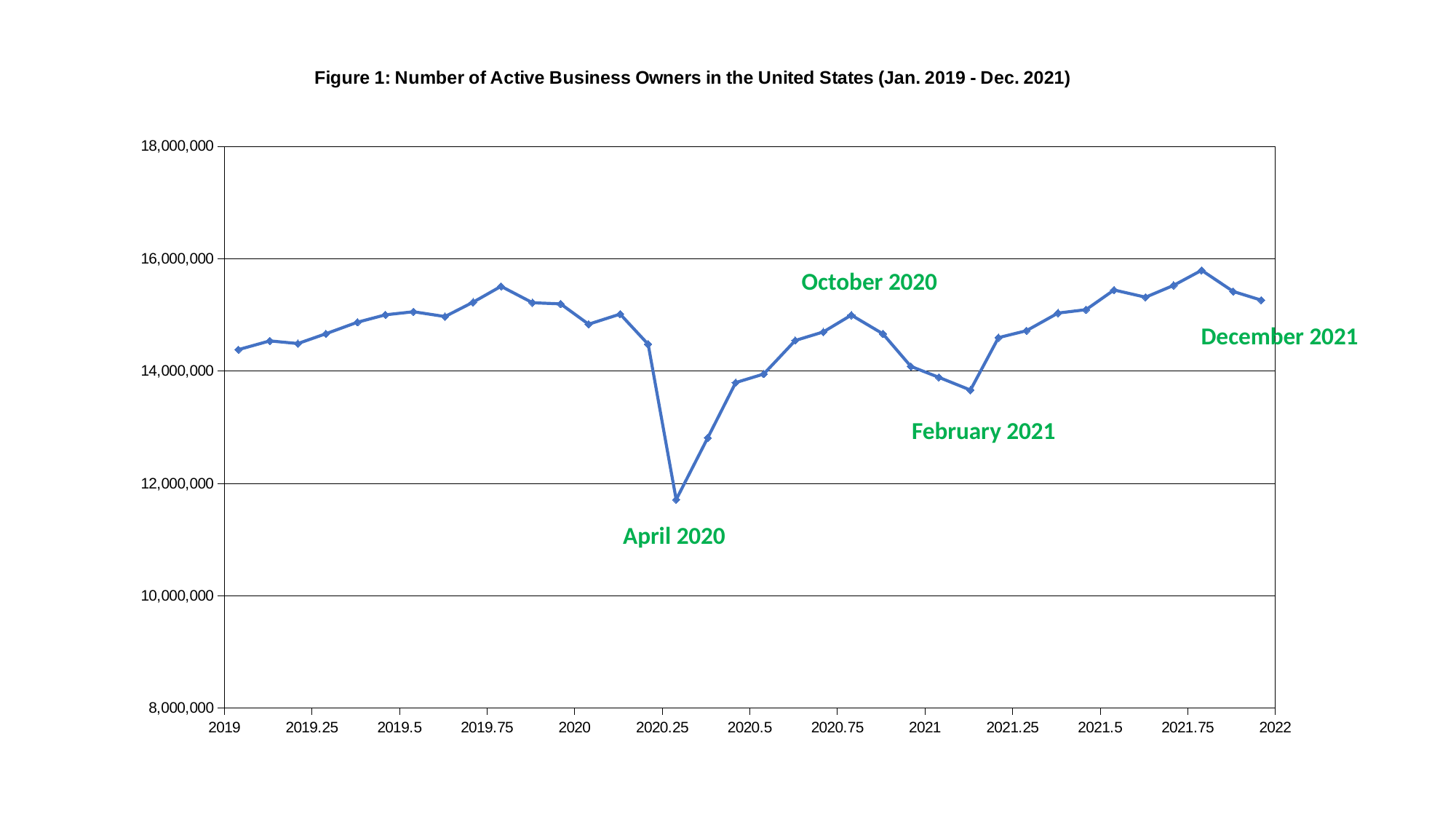
What is the title of the chart? Figure 1: Number of Active Business Owners in the United States (Jan. 2019 - Dec. 2021) Is the value for December 2021 greater or less than 14,000,000? greater Is the value for October 2020 greater or less than 14,000,000? greater Is the value for April 2020 greater or less than 12,000,000? less Does the line rise or fall between October 2020 and February 2021? fall Which is larger, the value for April 2020 or the value for December 2021? December 2021 What kind of chart is shown on the slide? Line chart Does the line rise or fall between April 2020 and October 2020? rise Which annotated month has the lowest number of active business owners? April 2020 How many green text annotations are placed on the chart? 4 Which is larger, the value for October 2020 or the value for February 2021? October 2020